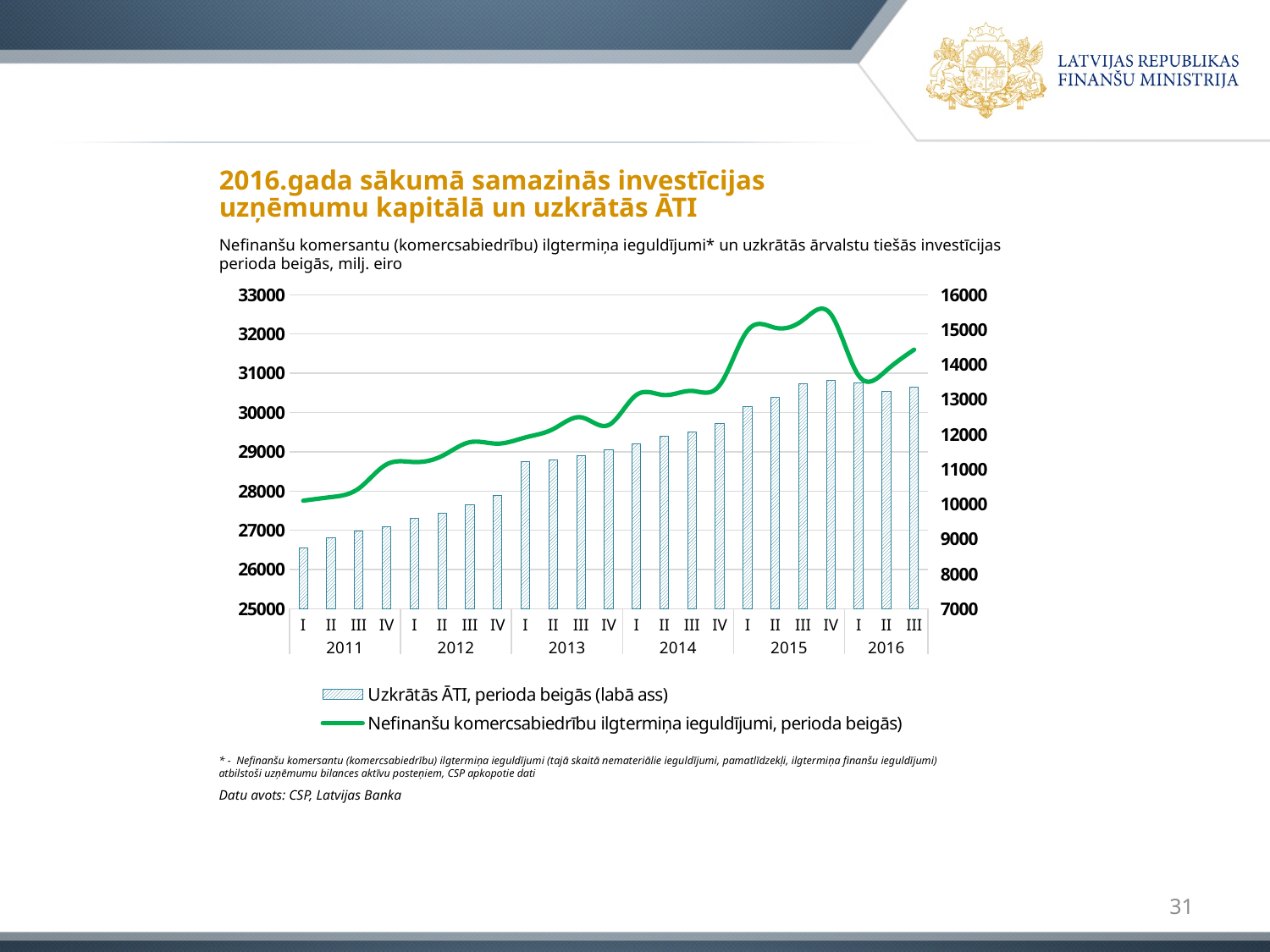
Which is higher on the line for Nefinanšu komercsabiedrību ilgtermiņa ieguldījumi: 2015 IV or 2016 I? 2015 IV What kind of chart is shown on the slide? A combined bar and line chart How many series does the legend list? 2 Is the line value for Nefinanšu komercsabiedrību ilgtermiņa ieguldījumi in 2015 IV greater or less than 32000 on the left axis? greater Which quarter has the lowest bar for Uzkrātās ĀTI? 2011 I In which quarter does the line for Nefinanšu komercsabiedrību ilgtermiņa ieguldījumi reach its highest point? 2015 IV Is the Uzkrātās ĀTI bar for 2016 III greater or less than 12000 on the right axis? greater Which axis does the legend say the Uzkrātās ĀTI series is plotted against? The right axis (labā ass) How many years are labelled on the x axis of the chart? 6 Which quarter has the highest bar for Uzkrātās ĀTI? 2015 IV Is the Uzkrātās ĀTI bar for 2011 I greater or less than 8000 on the right axis? greater How many quarterly data points (bars) are plotted on the chart? 23